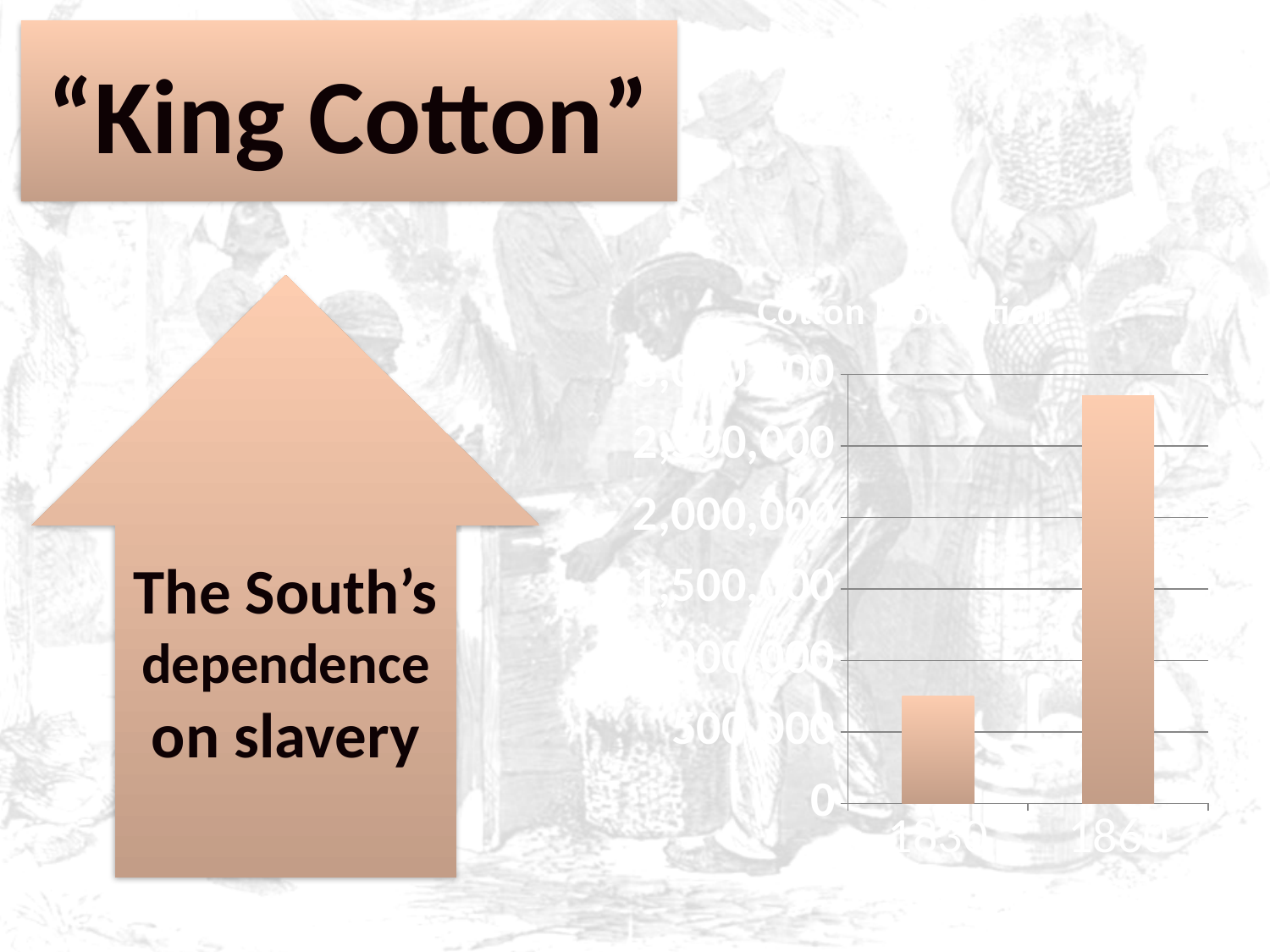
Is the value for 1830 greater or less than 1,000,000? less Is the bar for 1860 larger or smaller than the bar for 1830? larger What is the title of the chart? Cotton Production What is the highest value shown on the chart's vertical axis? 3,000,000 Do the values rise or fall from 1830 to 1860? rise What kind of chart is shown on the slide? bar chart Is the value for 1860 greater or less than 3,000,000? less Is the value for 1830 greater or less than 500,000? greater How many bars does the chart show? 2 Which year has the lower cotton production in the chart? 1830 Which year has the higher cotton production in the chart? 1860